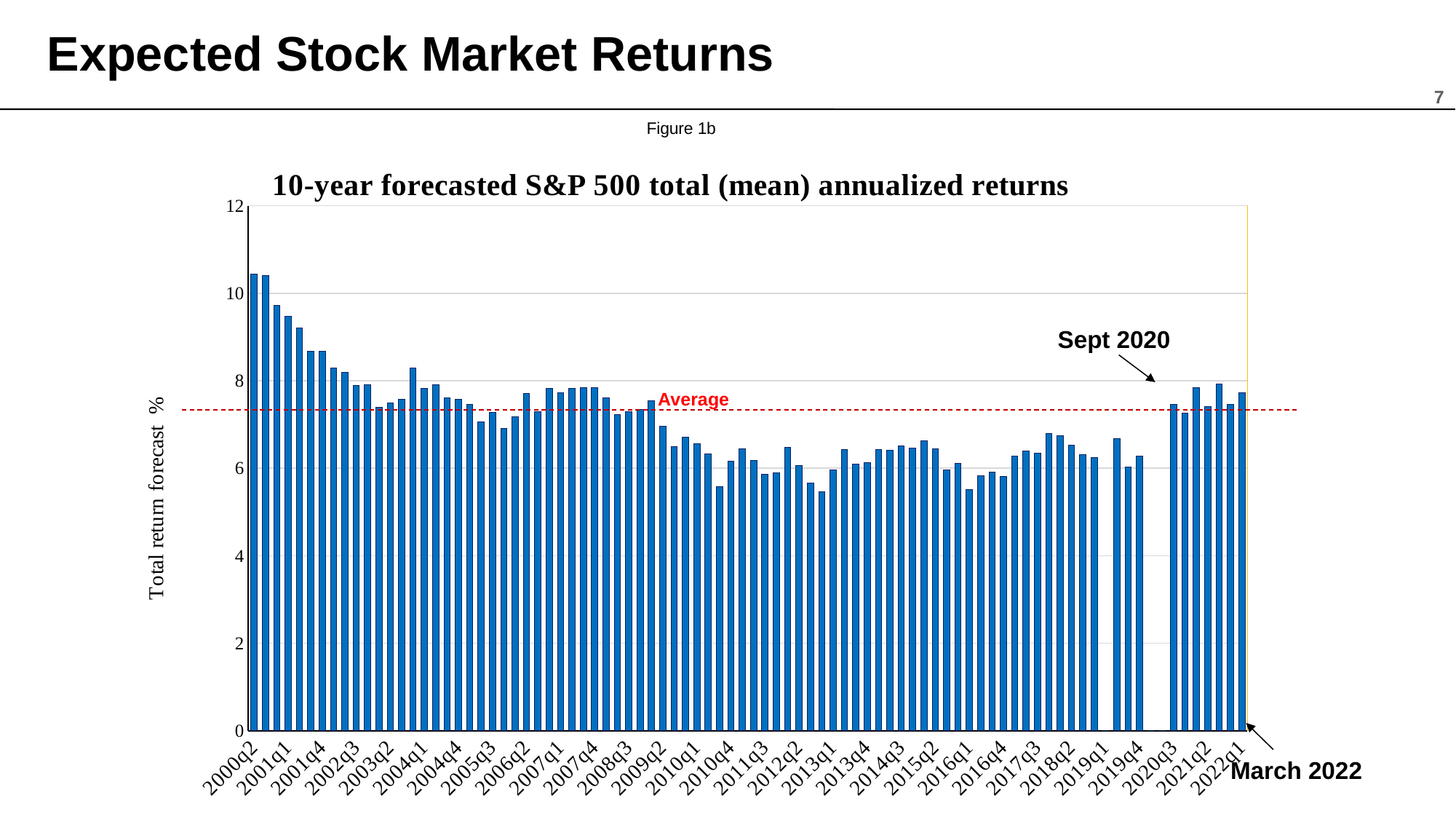
Do the values rise or fall from 2000q2 to 2003q2? fall Is the value for 2020q3 greater or less than 8? less Which is larger, the value for 2000q2 or the value for 2022q1? 2000q2 Which is larger, the value for 2001q4 or the value for 2010q1? 2001q4 Is the value for 2001q1 greater or less than 8? greater What kind of chart is shown on the slide? bar chart Is the value for 2022q1 greater or less than 6? greater What does the red dashed horizontal line on the chart represent? Average What is the title of the chart? 10-year forecasted S&P 500 total (mean) annualized returns